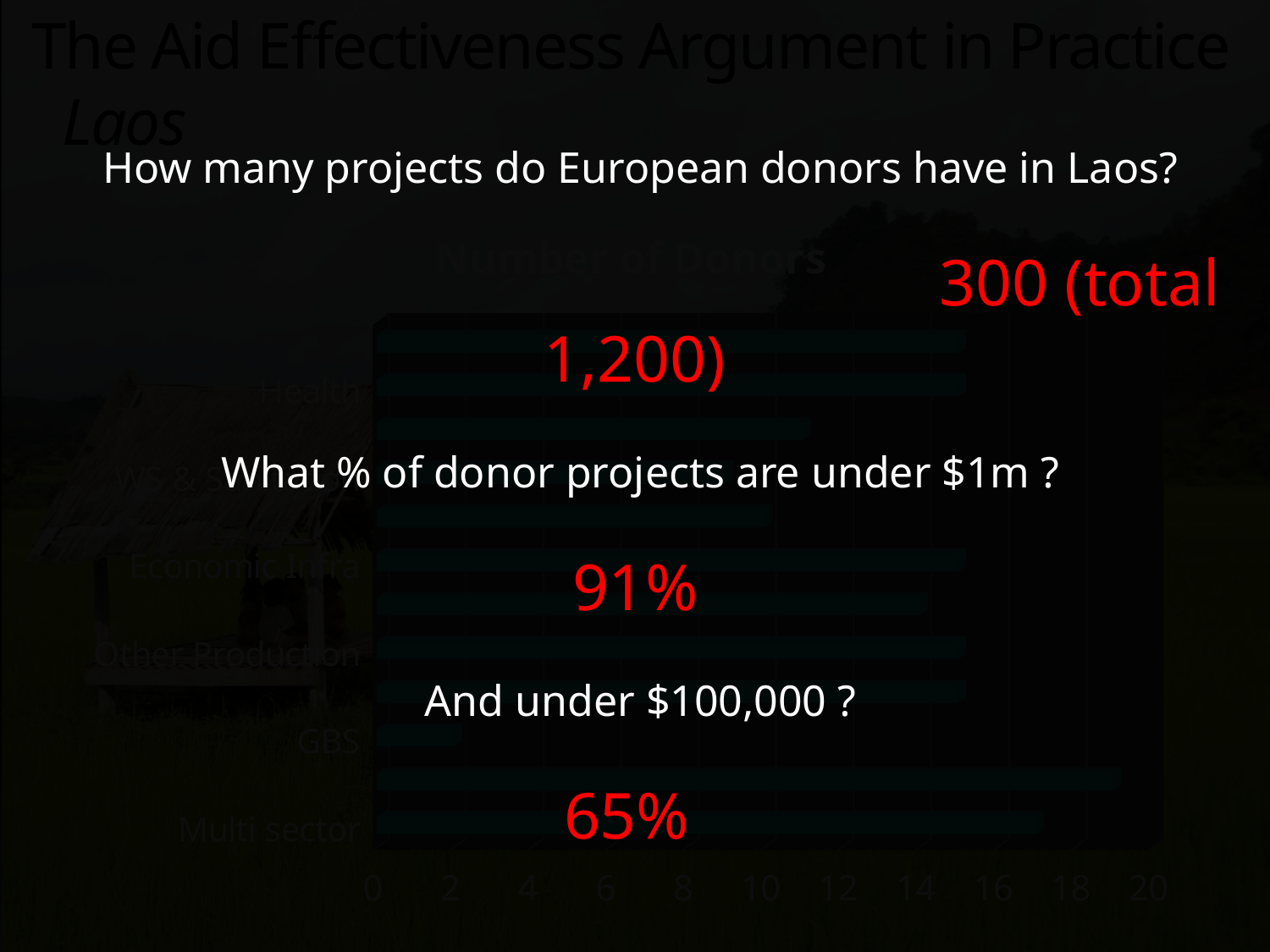
Is the value for Health greater or less than 10? greater What kind of chart is shown on the slide? bar chart What is the highest value shown on the chart's x axis? 20 Is the value for Multi sector greater or less than 10? greater What is the title of the chart on the slide? Number of Donors